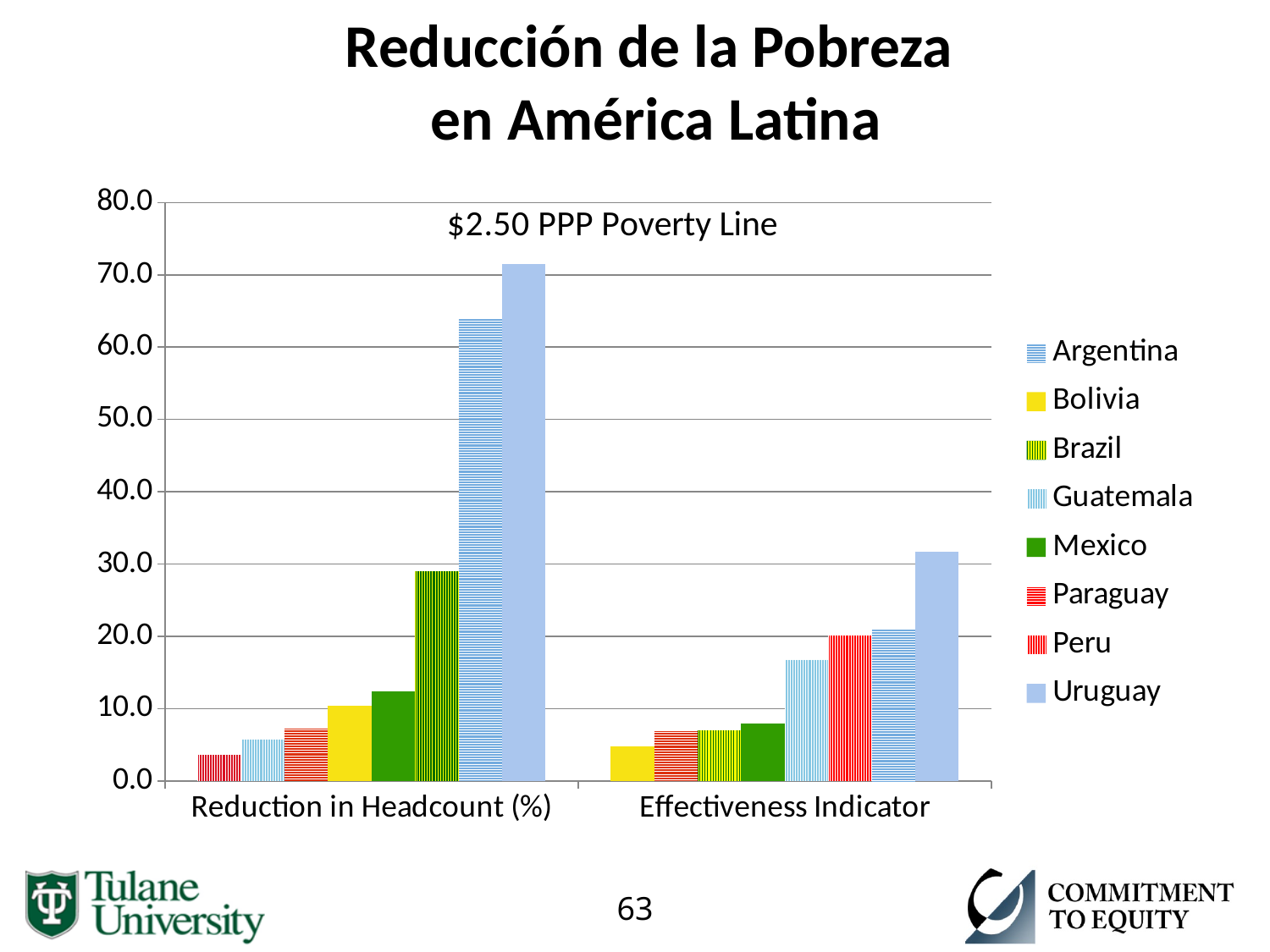
Which is larger for Effectiveness Indicator: Guatemala or Mexico? Guatemala What kind of chart is shown on the slide? bar chart Which country has the highest value for Effectiveness Indicator? Uruguay Is the value for Uruguay in Reduction in Headcount (%) greater or less than 70.0? greater What poverty line is named in the text inside the chart area? $2.50 PPP Poverty Line How many categories are shown on the x axis? 2 Which is larger for Reduction in Headcount (%): Brazil or Mexico? Brazil Is the value for Argentina in Reduction in Headcount (%) greater or less than 60.0? greater Which country has the highest value for Reduction in Headcount (%)? Uruguay How many series does the legend list? 8 Is the value for Uruguay in Effectiveness Indicator greater or less than 30.0? greater Which country has the lowest value for Effectiveness Indicator? Bolivia